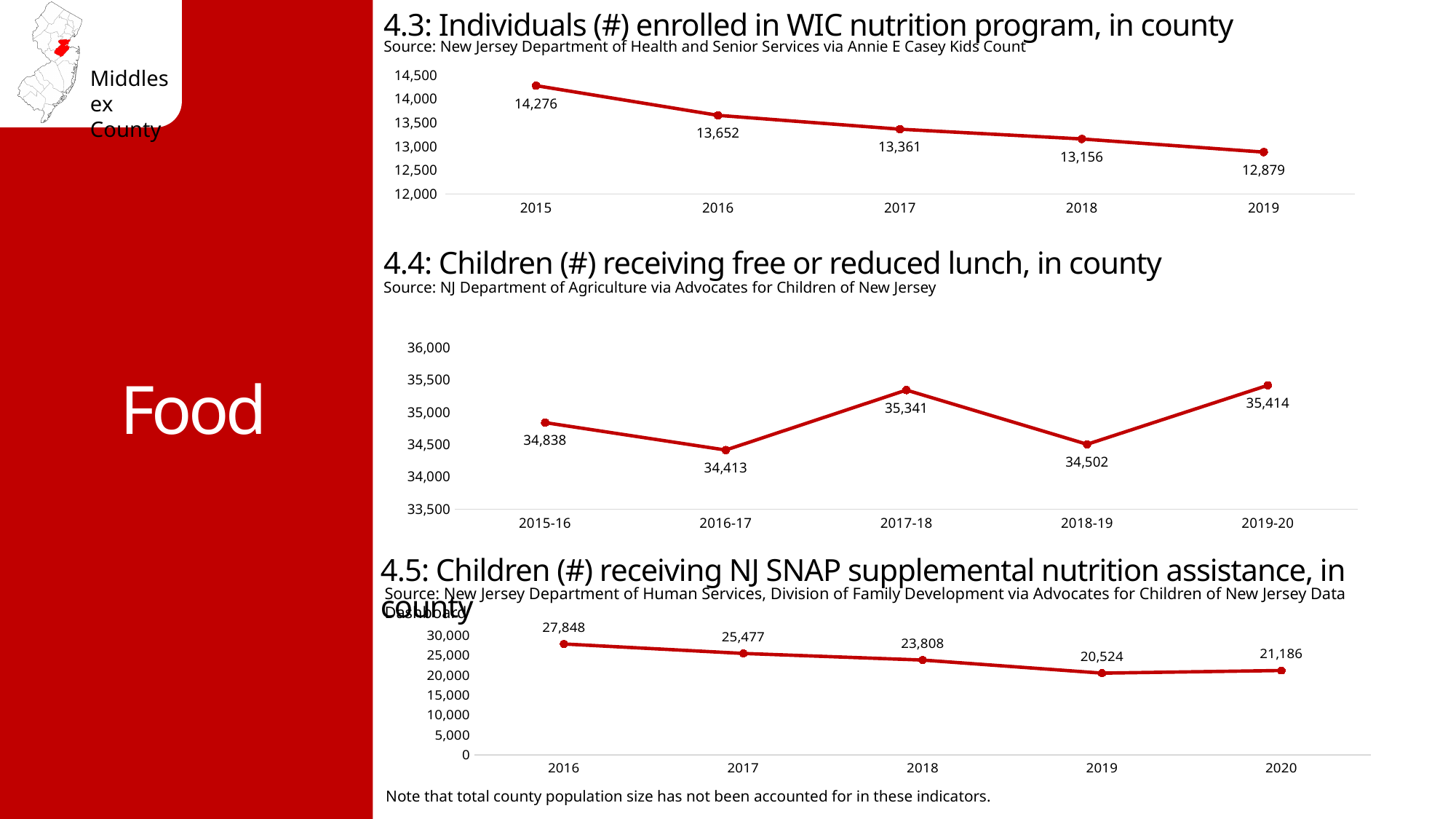
In the chart '4.3: Individuals (#) enrolled in WIC nutrition program, in county', which year has the lowest value? 2019 In the chart '4.5: Children (#) receiving NJ SNAP supplemental nutrition assistance, in county', which year has the highest value? 2016 What kind of chart is '4.5: Children (#) receiving NJ SNAP supplemental nutrition assistance, in county'? line chart In the chart '4.3: Individuals (#) enrolled in WIC nutrition program, in county', what is the value for 2017? 13,361 In the chart '4.5: Children (#) receiving NJ SNAP supplemental nutrition assistance, in county', what is the value for 2018? 23,808 In the chart '4.4: Children (#) receiving free or reduced lunch, in county', what is the value for 2016-17? 34,413 In the chart '4.4: Children (#) receiving free or reduced lunch, in county', which is larger, the value for 2015-16 or the value for 2018-19? 2015-16 In the chart '4.3: Individuals (#) enrolled in WIC nutrition program, in county', do the values rise or fall from 2015 to 2019? fall In the chart '4.5: Children (#) receiving NJ SNAP supplemental nutrition assistance, in county', what is the difference between the 2019 and 2020 values? 662 In the chart '4.4: Children (#) receiving free or reduced lunch, in county', which school year has the highest value? 2019-20 In the chart '4.4: Children (#) receiving free or reduced lunch, in county', how many data points are plotted? 5 In the chart '4.3: Individuals (#) enrolled in WIC nutrition program, in county', what is the difference between the 2015 and 2019 values? 1,397